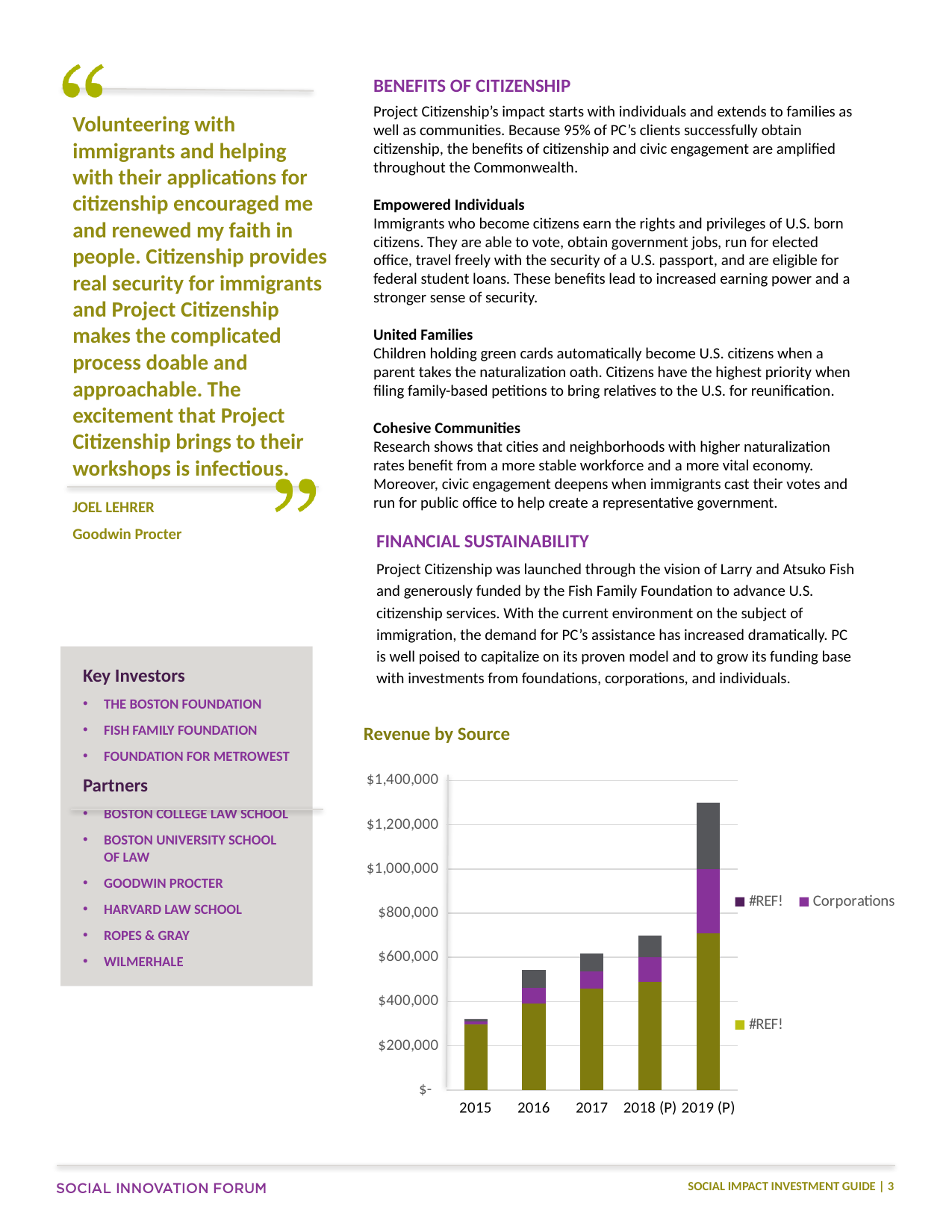
What is the title of the chart? Revenue by Source How many years (categories) are shown on the x axis of the Revenue by Source chart? 5 Which legend entry in the Revenue by Source chart is shown in purple? Corporations Is the total revenue for 2019 (P) greater or less than $1,200,000? greater Is the total revenue for 2018 (P) greater or less than $800,000? less What kind of chart is the Revenue by Source chart? stacked bar chart Which year has the highest total revenue in the Revenue by Source chart? 2019 (P) How many series does the legend of the Revenue by Source chart list? 3 Is the total revenue for 2015 greater or less than $400,000? less Does total revenue rise or fall from 2015 to 2019 (P) in the Revenue by Source chart? rise Which year has the larger total revenue, 2016 or 2018 (P)? 2018 (P) Which year has the lowest total revenue in the Revenue by Source chart? 2015